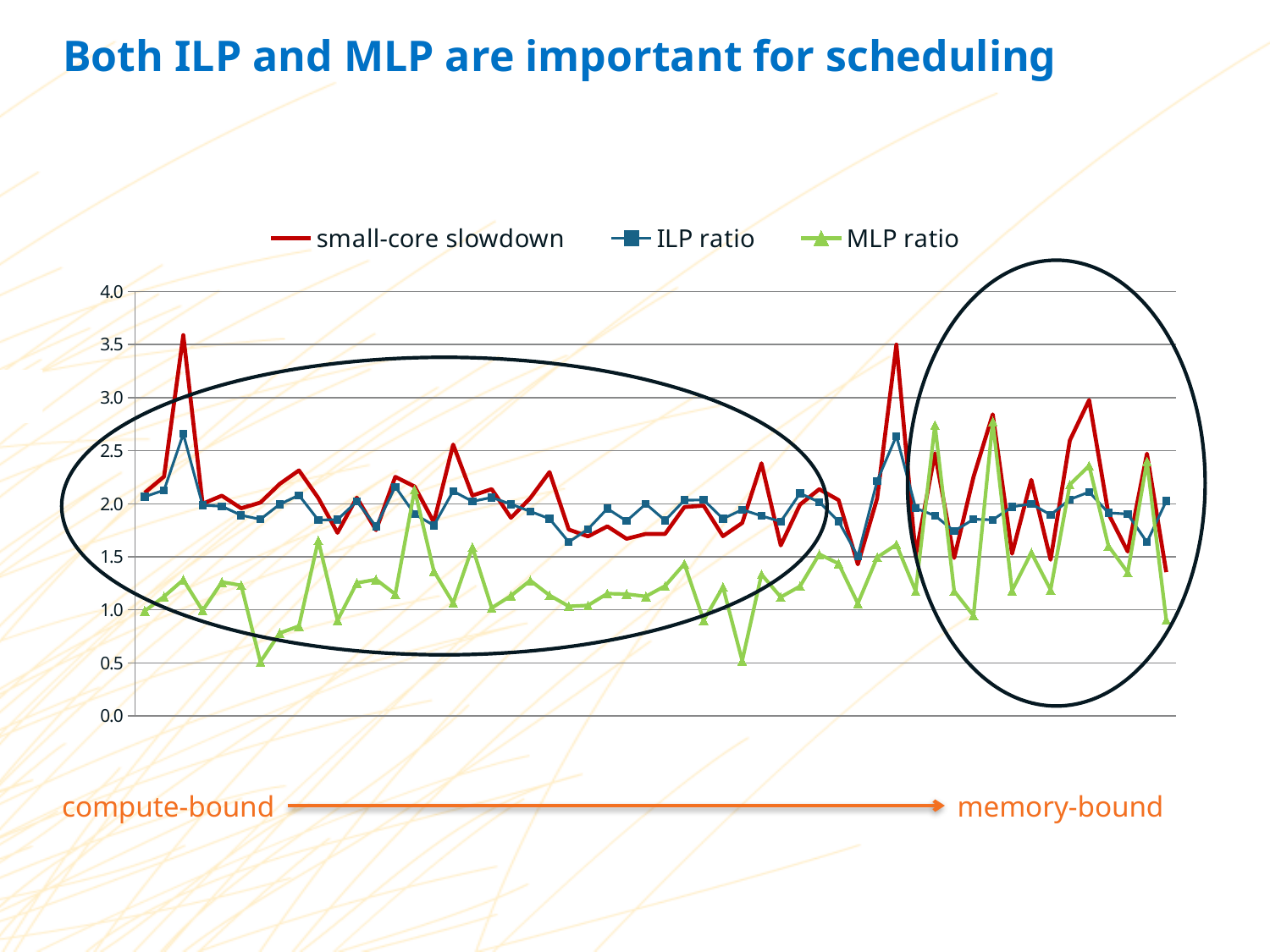
According to the arrow below the chart, what does the left end of the x axis represent and what does the right end represent? compute-bound on the left, memory-bound on the right How many series does the legend list? 3 What is the lowest value shown on the y axis? 0.0 What is the title of the slide containing the chart? Both ILP and MLP are important for scheduling Is the lowest point of the MLP ratio line greater or less than 1.0? less Is the highest point of the ILP ratio line greater or less than 3.0? less Which series reaches the highest value anywhere on the chart? small-core slowdown What is the highest value shown on the y axis? 4.0 What kind of chart is shown on the slide? line chart Is the highest point of the small-core slowdown line greater or less than 3.0? greater Which series stays lowest across most of the x axis? MLP ratio What are the three series named in the legend? small-core slowdown, ILP ratio, MLP ratio